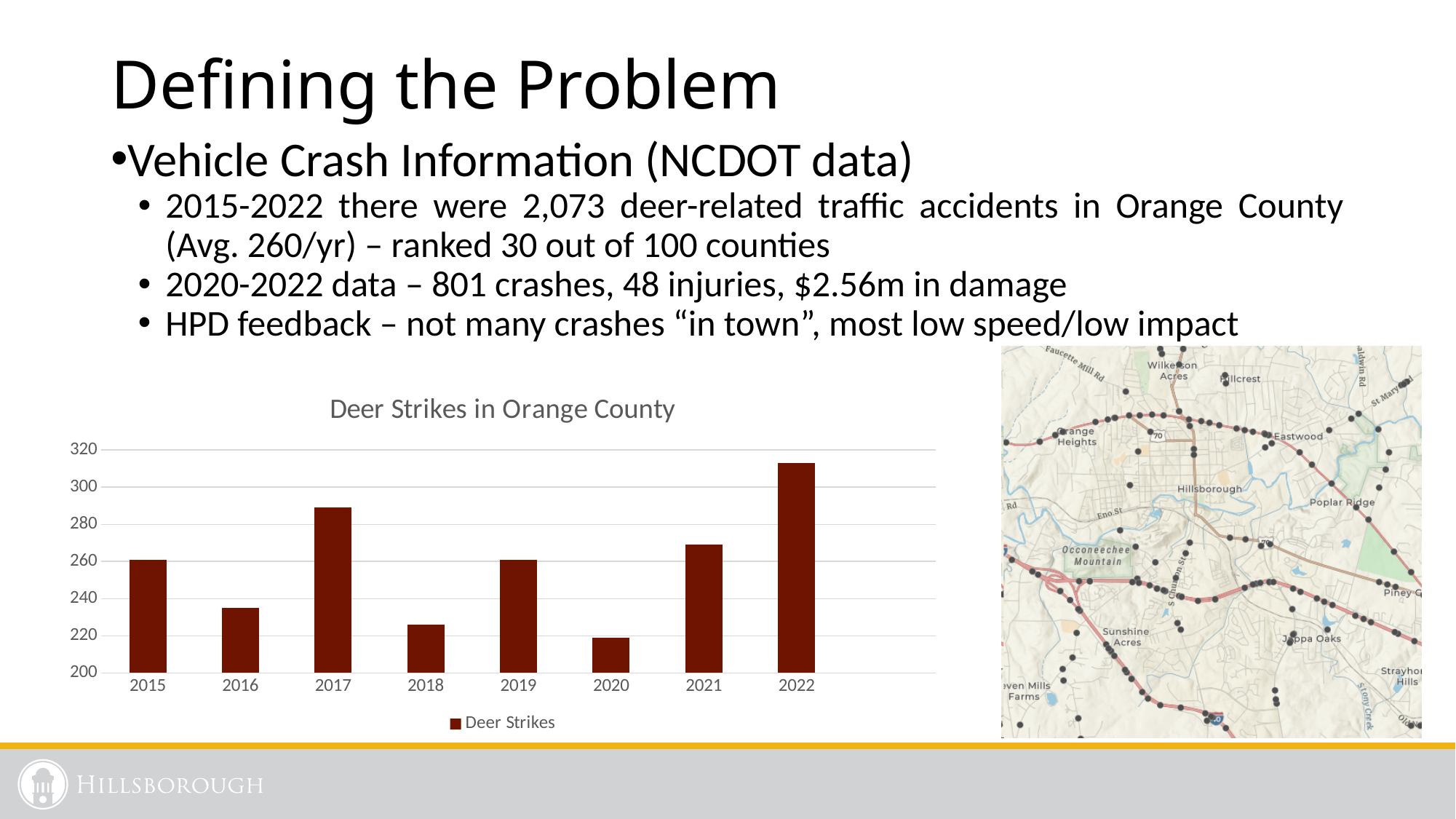
Which year has more deer strikes, 2021 or 2018? 2021 Which year has the highest number of deer strikes in the chart? 2022 Which year has the lowest number of deer strikes in the chart? 2020 How many series does the chart legend list? 1 What type of chart is shown on the slide? bar chart What is the title of the chart? Deer Strikes in Orange County Do the deer strike values rise or fall from 2020 to 2022? rise How many years are shown on the x axis of the chart? 8 Is the value for 2016 greater or less than 240? less Is the value for 2022 greater or less than 300? greater Which year has more deer strikes, 2017 or 2016? 2017 Is the value for 2017 greater or less than 280? greater